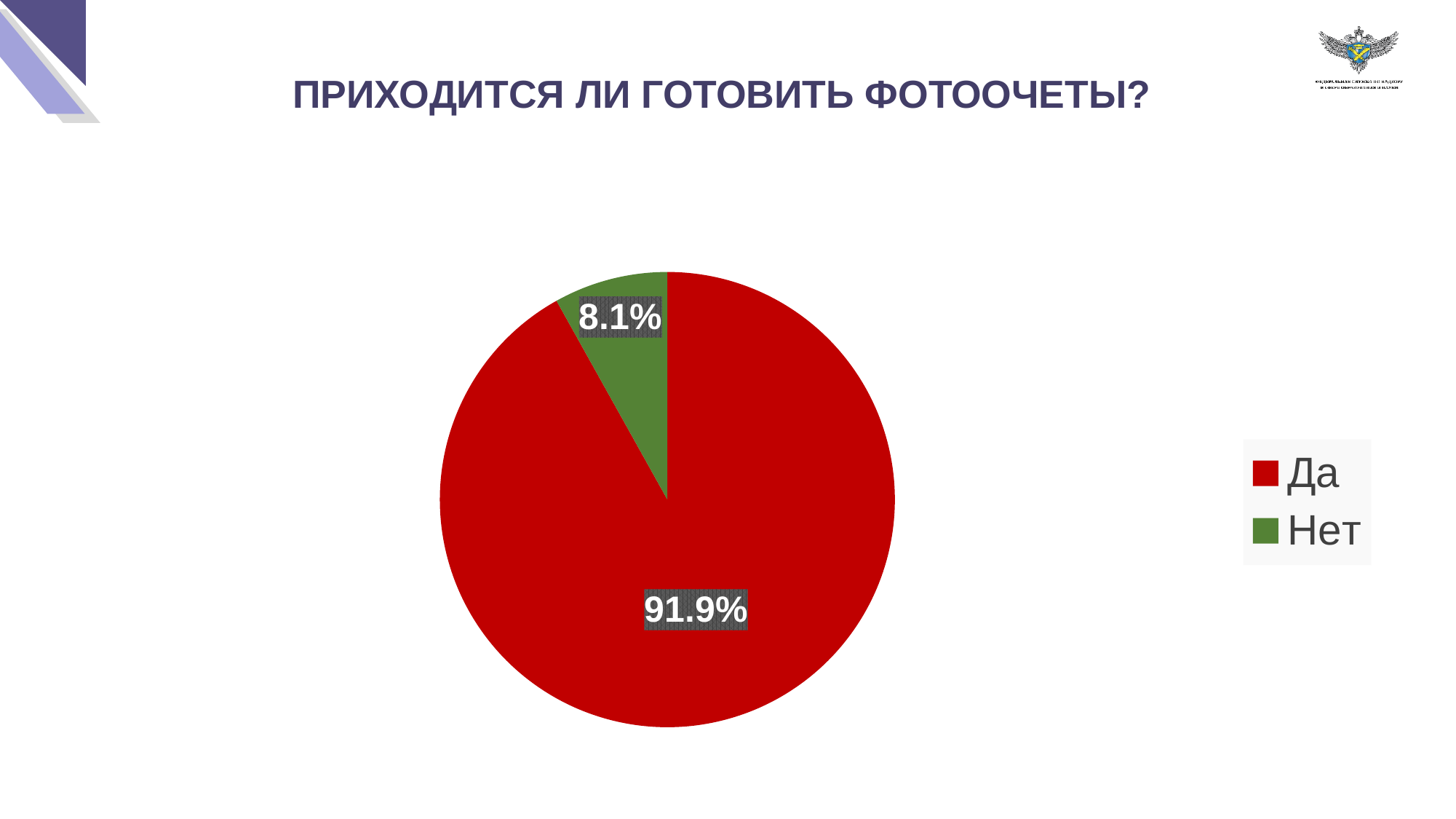
Which category has the largest slice of the pie? Да What kind of chart is shown on the slide? Pie chart What is the difference in percentage points between the "Да" and "Нет" slices? 83.8 What is the value shown for the "Да" slice? 91.9% How many entries does the legend list? 2 What share of the pie does "Да" represent? 91.9% Which slice is larger, "Да" or "Нет"? Да What share of the pie does "Нет" represent? 8.1% Which category has the smallest slice of the pie? Нет What colour is the "Нет" slice? Green How many slices does the pie chart have? 2 What is the value shown for the "Нет" slice? 8.1%